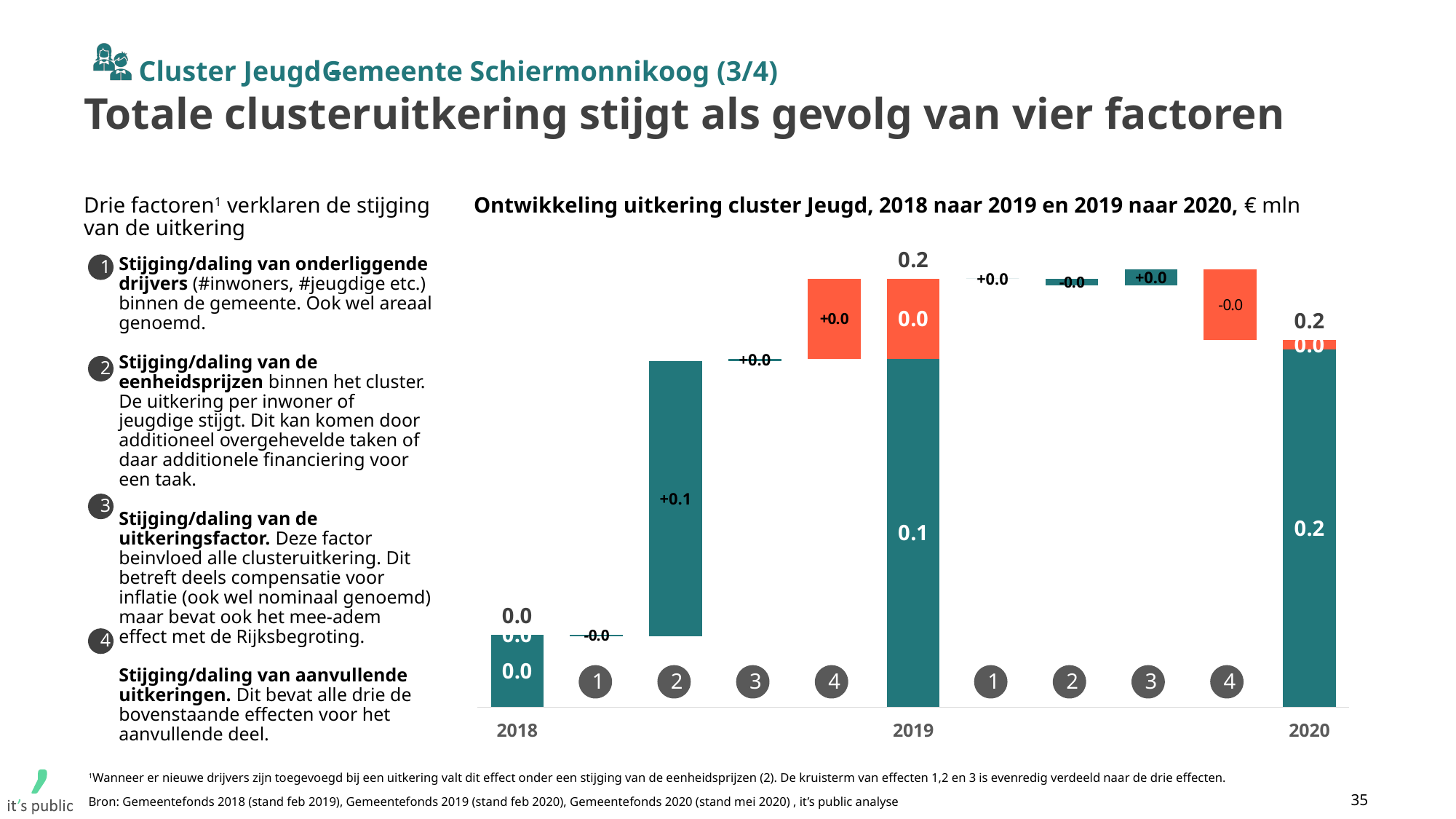
What is the total value shown for 2019 in the chart? 0.2 What is the value of the factor 2 step between 2018 and 2019? +0.1 Which factor step between 2018 and 2019 has the largest value? Factor 2 (+0.1) What kind of chart is shown on the slide? Waterfall bar chart What is the total value shown for 2018 in the chart? 0.0 Which year has the lowest total value in the chart? 2018 In what unit are the values in the chart expressed? € mln What is the difference between the 2020 total and the 2018 total? 0.2 Is the total for 2020 larger or smaller than the total for 2018? Larger What is the teal (lower) segment value of the 2019 bar? 0.1 What is the value of the factor 4 step between 2019 and 2020? -0.0 What is the total value shown for 2020 in the chart? 0.2